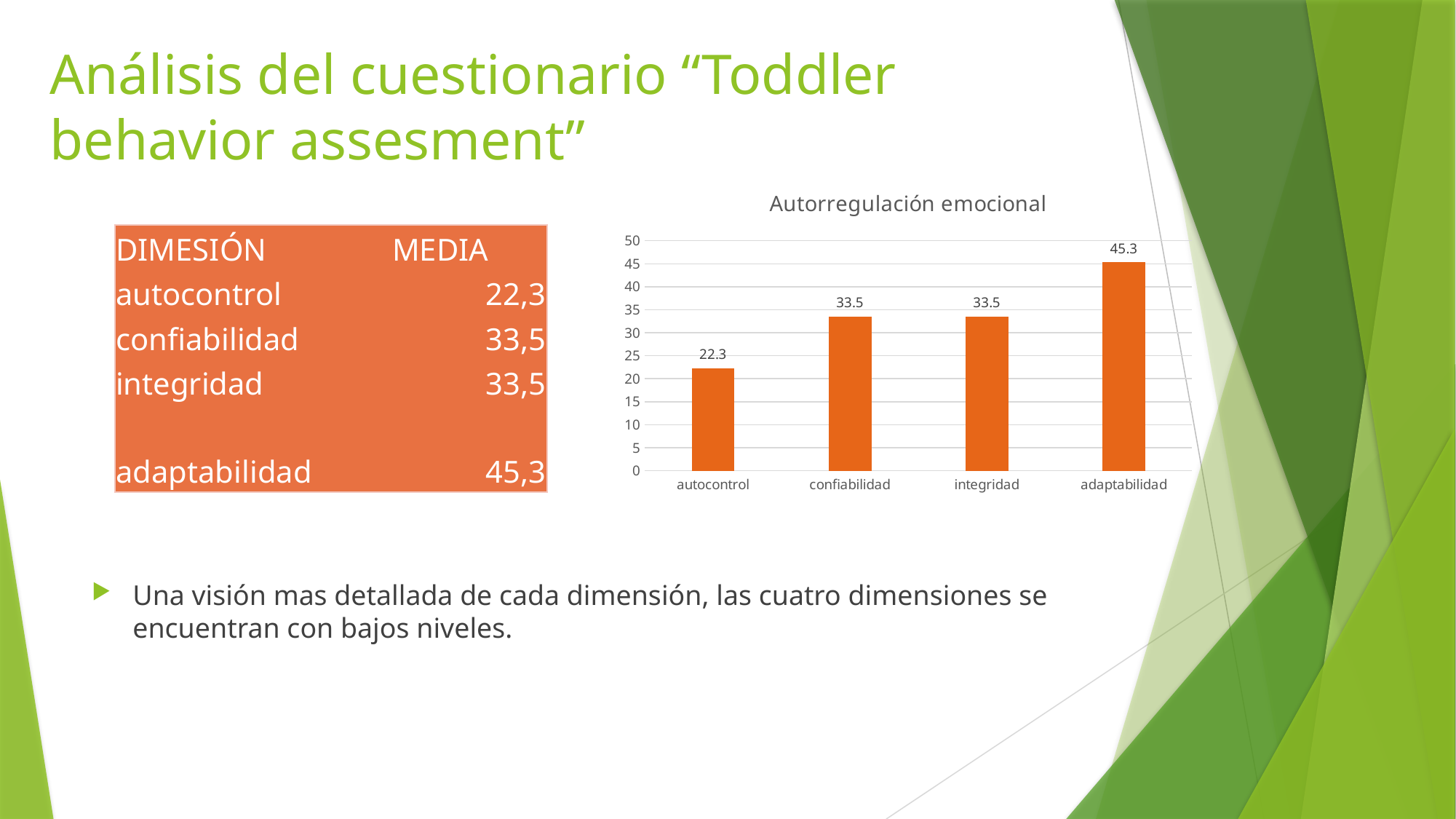
Which category has the highest value in the chart? adaptabilidad What is the difference between the values for integridad and autocontrol? 11.2 What kind of chart is shown on the slide? bar chart Is the value for autocontrol greater or less than 25? less What is the title of the chart? Autorregulación emocional What is the value for adaptabilidad in the chart? 45.3 What is the difference between the values for adaptabilidad and autocontrol? 23.0 What is the value for confiabilidad in the chart? 33.5 Which category has the lowest value in the chart? autocontrol What is the value for autocontrol in the chart? 22.3 Which is larger, the value for adaptabilidad or the value for integridad? adaptabilidad How many categories are shown on the x axis of the chart? 4